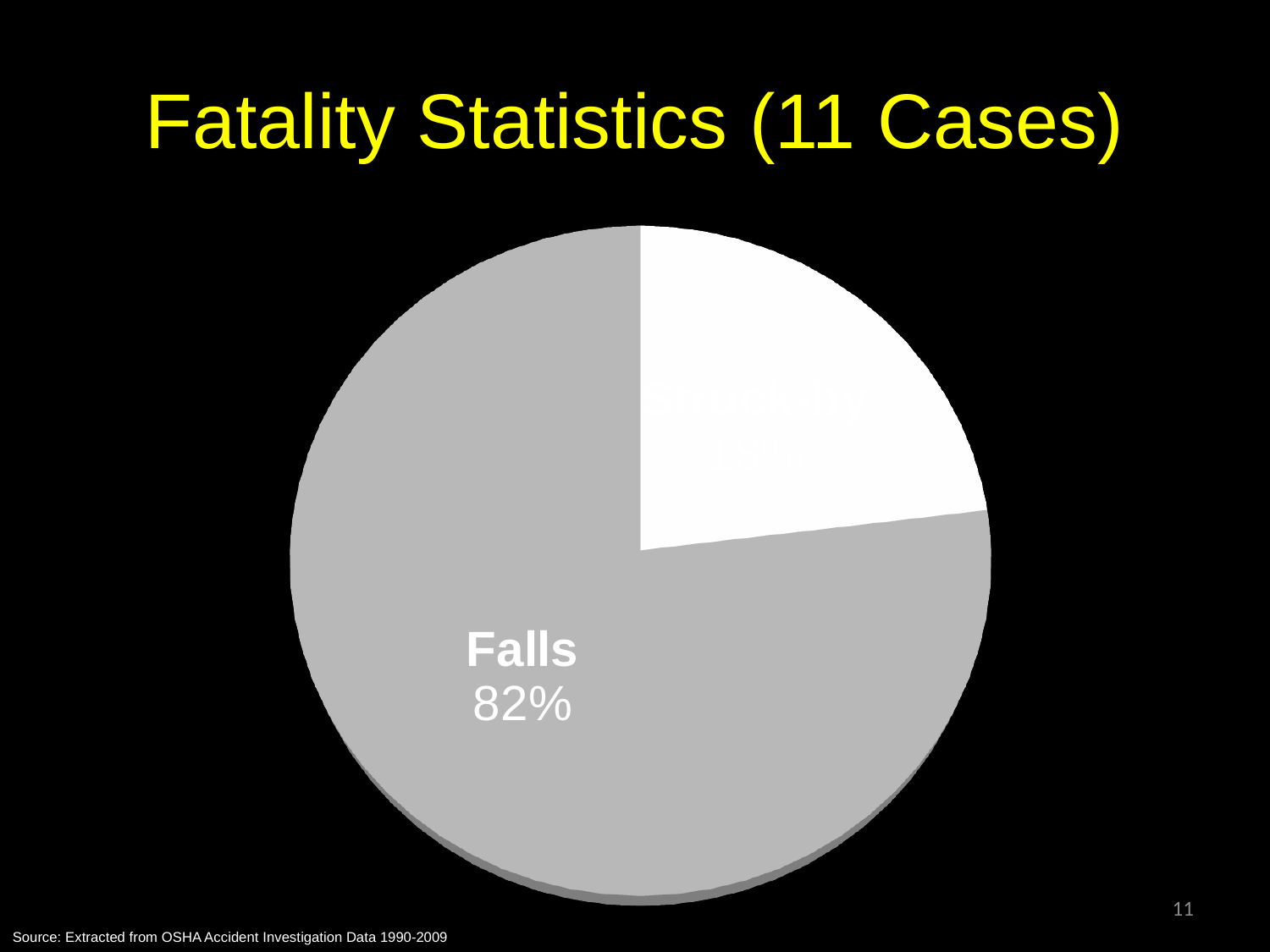
How many slices does the pie chart have? 2 What colour is the Falls slice of the pie? grey Which slice of the pie is the largest? Falls Which slice is larger, the grey slice or the white slice? the grey slice (Falls) Is the share for Falls greater or less than 50%? greater What is the title of the chart on the slide? Fatality Statistics (11 Cases) What type of chart is shown on the slide? pie chart How many cases does the chart title say the statistics are based on? 11 What share of the pie does the Falls slice represent? 82%